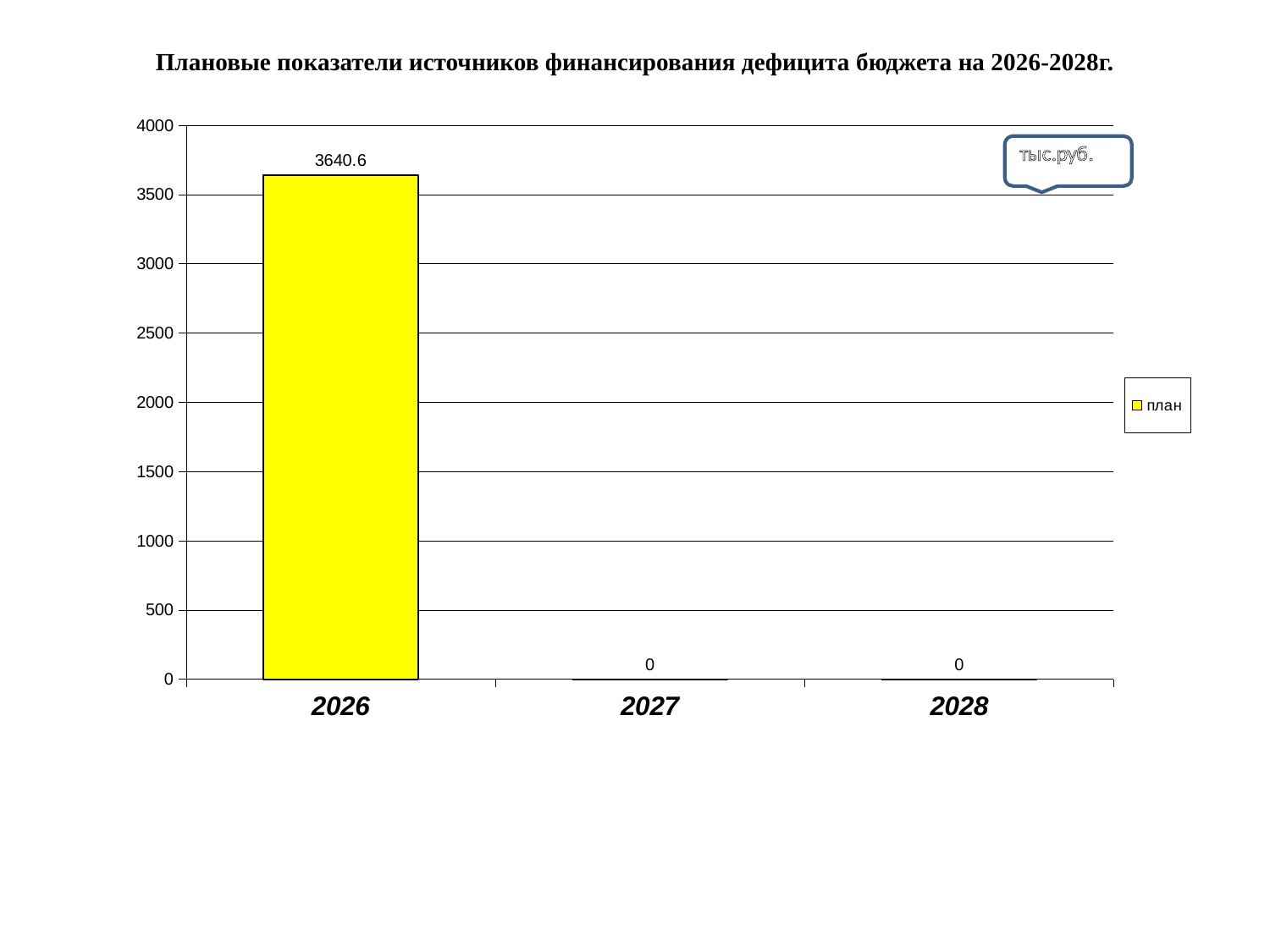
Which year has the highest value? 2026 Is the value for 2026 greater or less than 3500? greater What is the difference between the values for 2026 and 2027? 3640.6 How many years are shown on the x axis? 3 Which is larger, the value for 2026 or the value for 2028? 2026 Do the values rise or fall from 2026 to 2028? fall What is the name of the series in the legend? план What kind of chart is shown? bar chart How many series does the legend list? 1 What is the value for 2026? 3640.6 What is the value for 2027? 0 What is the value for 2028? 0